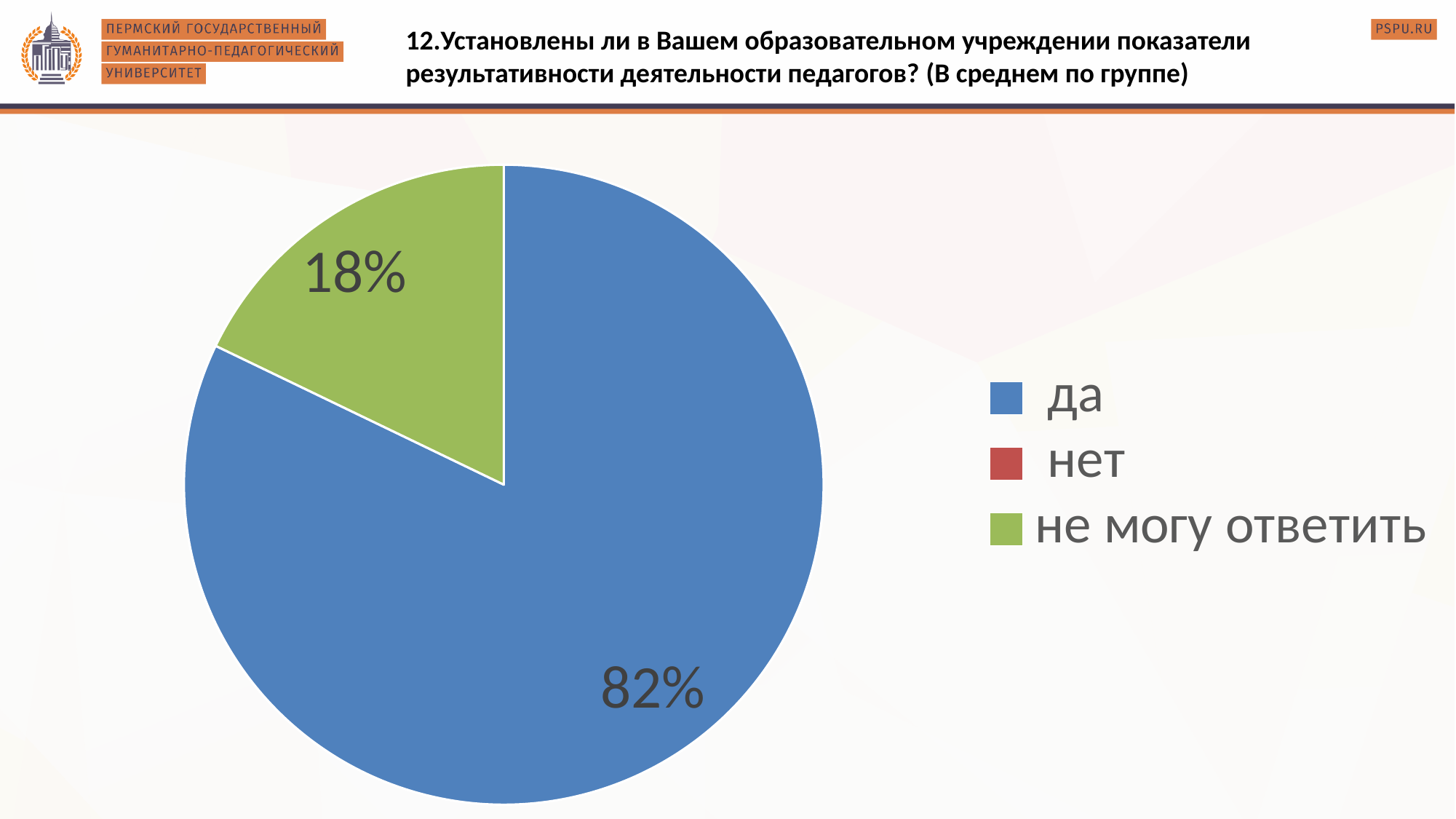
Which category has the largest slice of the pie? да What colour is the "да" slice? blue Which of the two labelled slices is larger, "да" or "не могу ответить"? да What share of the pie does the "да" slice take? 82% Which legend entry is shown in green? не могу ответить How many entries does the legend list? 3 What is the difference in percentage points between the "да" slice and the "не могу ответить" slice? 64 Is the share for "да" greater or less than 50%? greater What kind of chart is shown on the slide? pie chart What share of the pie does the "не могу ответить" slice take? 18% How many slices have a percentage label printed on the pie? 2